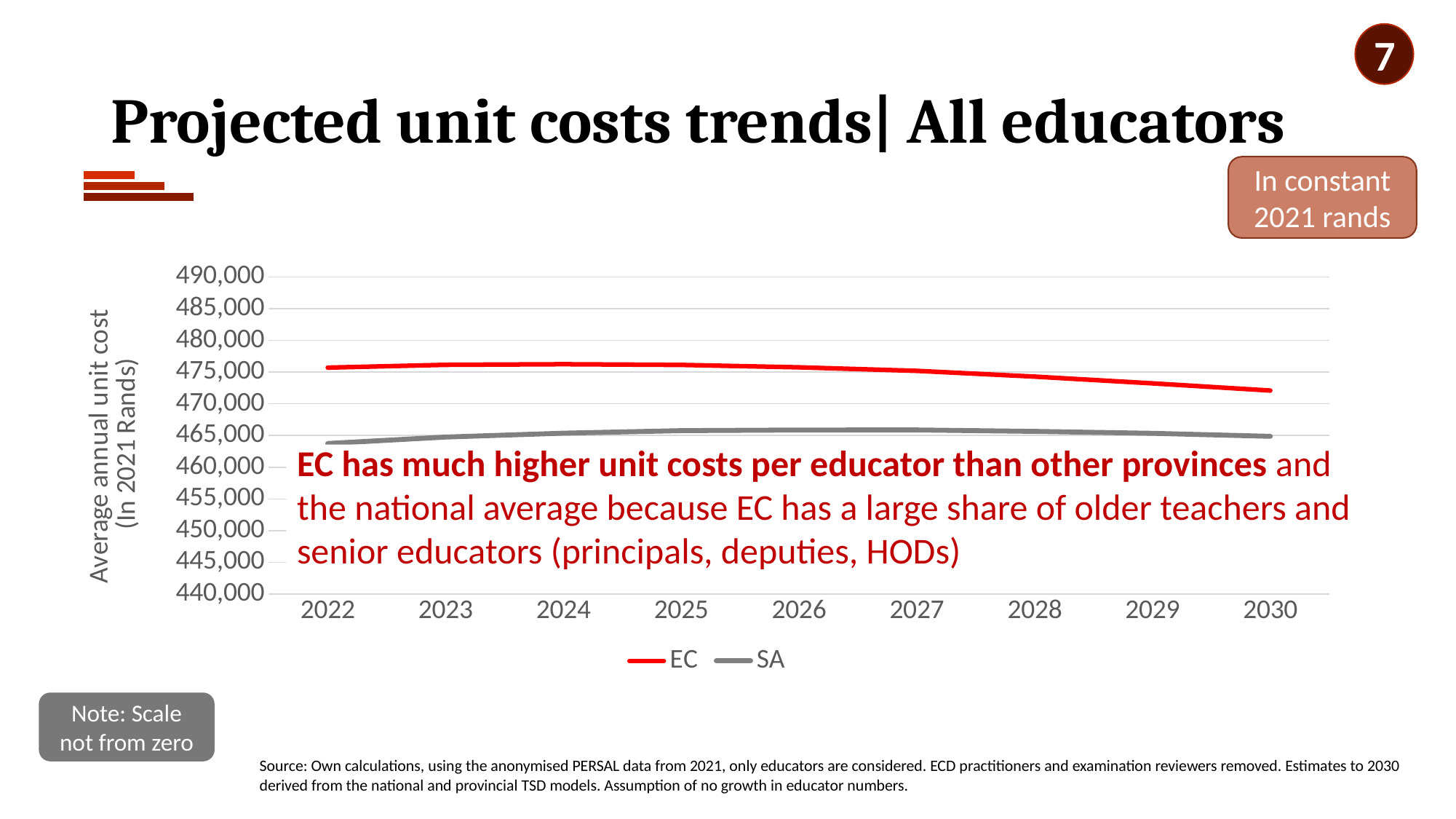
How many series does the legend list? 2 Is the value for EC in 2030 greater or less than 475,000? less What is the y-axis title of the chart? Average annual unit cost (In 2021 Rands) Which series has the higher unit cost in 2022, EC or SA? EC Which series are listed in the legend? EC and SA Is the value for SA in 2022 greater or less than 465,000? less How many years are plotted along the x axis? 9 Is the value for EC in 2030 greater or less than 470,000? greater Which series has the higher unit cost in 2030, EC or SA? EC Does the EC series rise or fall between 2025 and 2030? fall What kind of chart is shown on the slide? line chart In which year is the EC series at its lowest? 2030